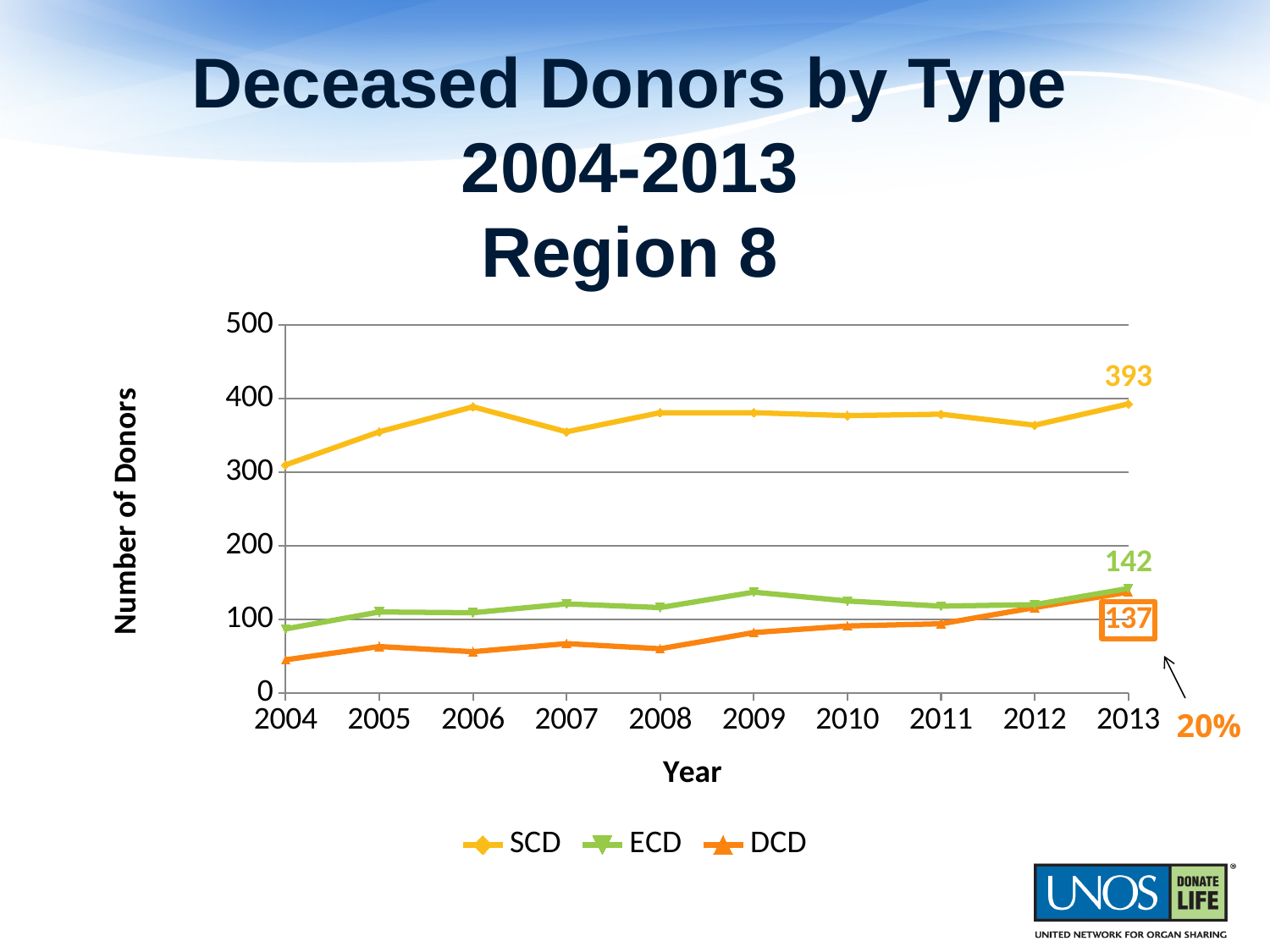
What is the difference between the SCD and ECD values in 2013? 251 Is the value for SCD in 2004 greater or less than 400? less In 2013, which is larger, the ECD value or the DCD value? ECD Which series has the highest value in 2013? SCD What kind of chart is shown on the slide? line chart What is the value for ECD in 2013? 142 What is the value for SCD in 2013? 393 How many series does the legend list? 3 Is the value for DCD in 2004 greater or less than 100? less What is the value for DCD in 2013? 137 Which series has the lowest value in 2004? DCD How many years are shown on the x axis? 10